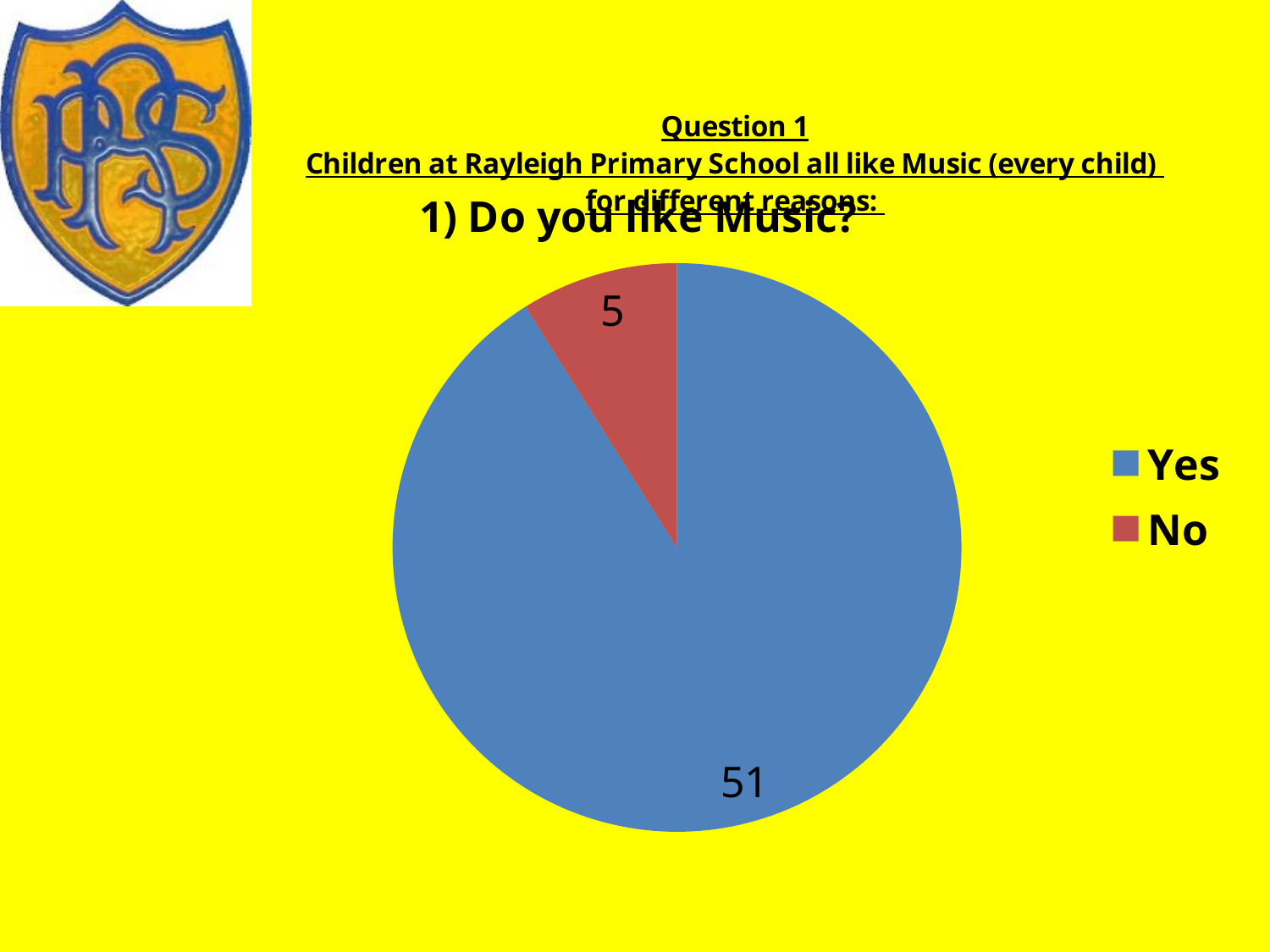
Which is larger, the value for Yes or the value for No? Yes How many categories does the pie chart have? 2 What is the value for No in the pie chart? 5 What kind of chart is shown on the slide? pie chart What is the total of all the slices in the pie chart? 56 Which category has the largest slice of the pie chart? Yes How many entries does the legend list? 2 What is the title of the chart? 1) Do you like Music? Which category has the smallest slice of the pie chart? No What is the value for Yes in the pie chart? 51 What colour is the No slice in the pie chart? red What is the difference between the Yes and No values? 46